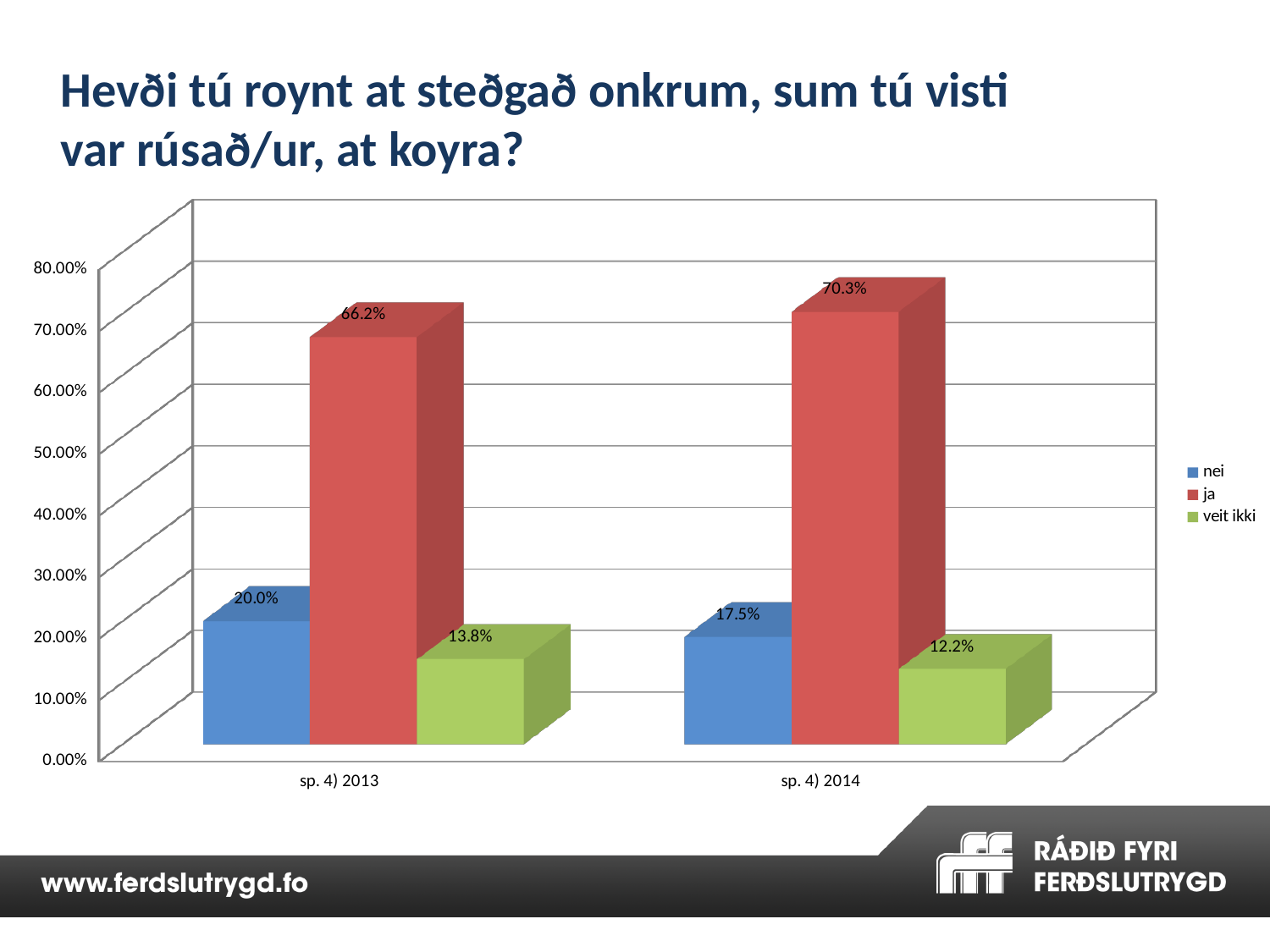
How many categories are shown on the x axis? 2 Which series has the lowest value in sp. 4) 2014? veit ikki How many series does the legend list? 3 What kind of chart is shown on the slide? Bar chart Which series has the highest value in sp. 4) 2013? ja What is the value for "veit ikki" in sp. 4) 2014? 12.2% What is the difference between the "ja" values for sp. 4) 2014 and sp. 4) 2013? 4.1% What is the value for "ja" in sp. 4) 2014? 70.3% What is the value for "veit ikki" in sp. 4) 2013? 13.8% Which is larger: "nei" in sp. 4) 2013 or "nei" in sp. 4) 2014? nei in sp. 4) 2013 Does the value for "ja" rise or fall from sp. 4) 2013 to sp. 4) 2014? Rise What is the value for "nei" in sp. 4) 2013? 20.0%